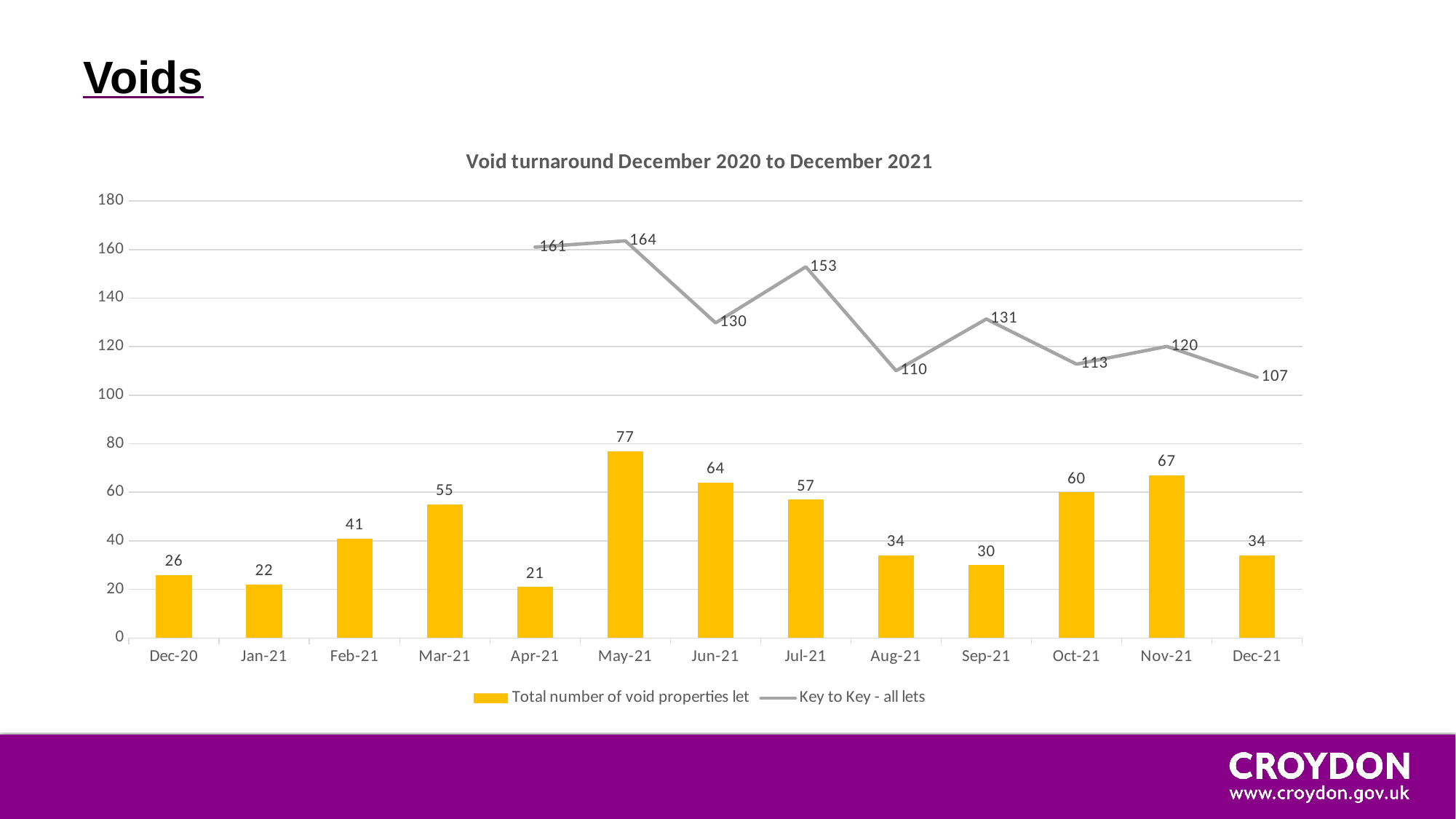
How many series does the legend list? 2 What is the title of the chart? Void turnaround December 2020 to December 2021 Does the Key to Key - all lets line generally rise or fall from Apr-21 to Dec-21? Fall What kind of chart is used for the 'Total number of void properties let' series? Bar chart Which month has the lowest total number of void properties let? Apr-21 How many months are shown on the x axis? 13 Which month has the highest total number of void properties let? May-21 Which month has the highest Key to Key - all lets value? May-21 What is the difference between the total number of void properties let in Nov-21 and Dec-21? 33 What is the Key to Key - all lets value for Aug-21? 110 Which is larger, the Key to Key - all lets value for Jul-21 or for Sep-21? Jul-21 What is the total number of void properties let in May-21? 77